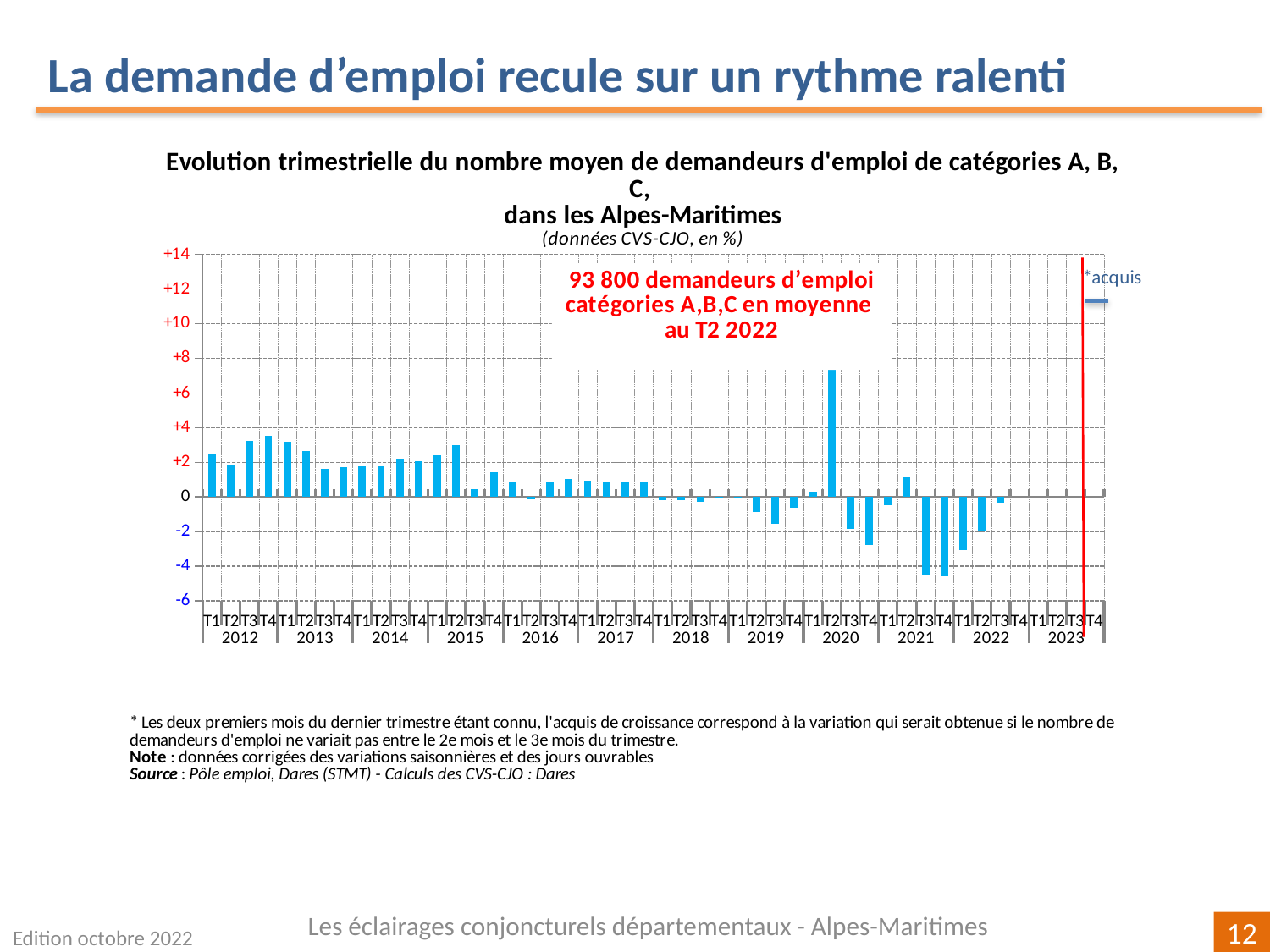
How many years are labelled on the x axis of the chart? 12 Which is larger, the value for T1 2012 or the value for T1 2016? T1 2012 In which year does the lowest bar on the chart occur? 2021 What is the highest value shown on the y axis of the chart? +14 In which quarter is the highest bar on the chart? T2 2020 Is the value for T4 2021 greater or less than -2? less Is the value for T2 2020 greater or less than +6? greater Do the bar values generally rise or fall from 2012 to 2016? fall What kind of chart is shown on the slide? bar chart Is the value for T4 2012 greater or less than +2? greater Which is larger, the value for T2 2020 or the value for T4 2012? T2 2020 According to the annotation on the chart, how many demandeurs d'emploi catégories A,B,C were there on average in T2 2022? 93 800